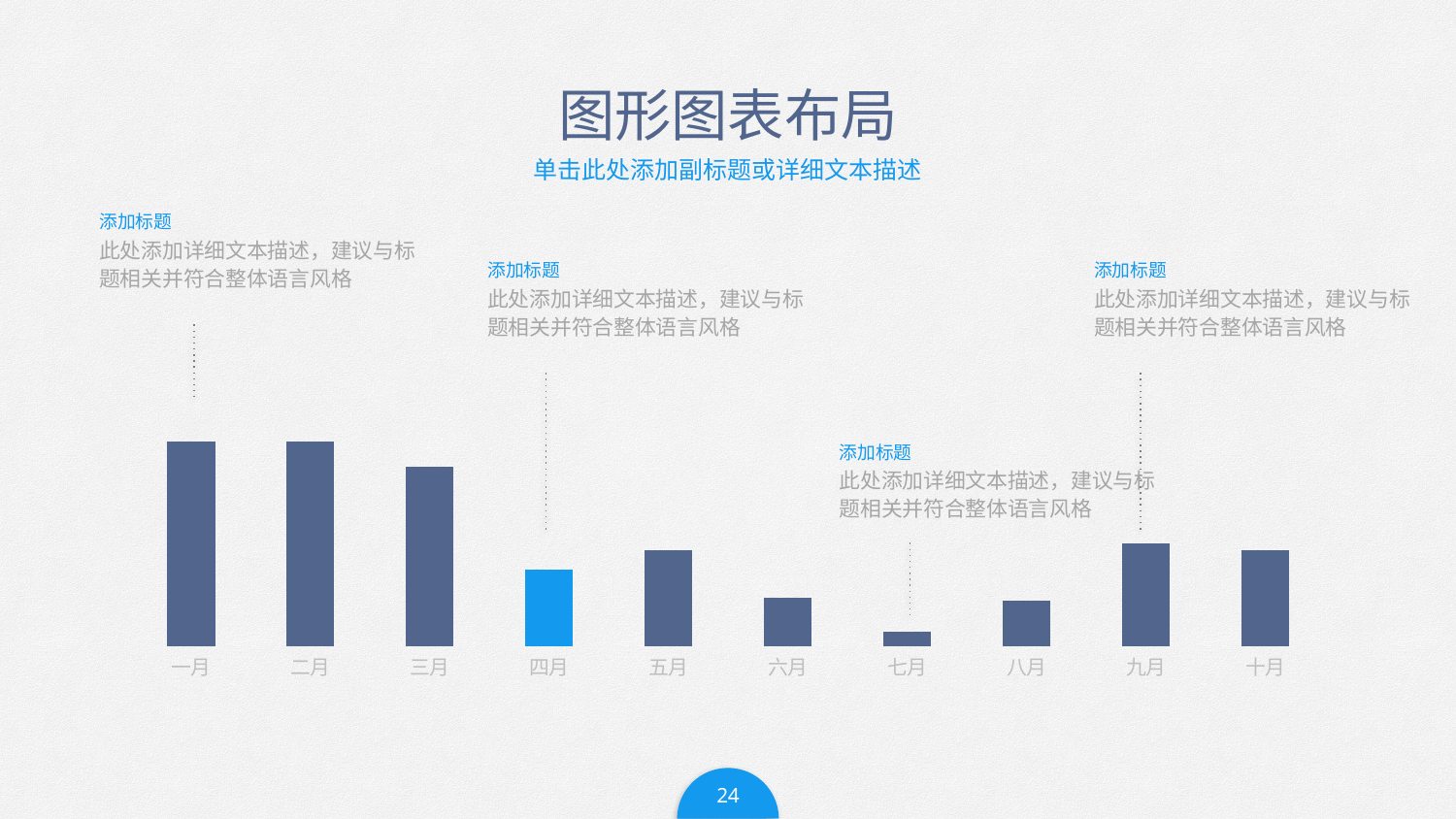
Do the values rise or fall from 七月 to 九月? rise Which is larger, the value for 八月 or the value for 九月? 九月 What is the main title of the slide containing the chart? 图形图表布局 Do the values rise or fall from 五月 to 七月? fall Which is larger, the value for 一月 or the value for 四月? 一月 How many categories (months) are plotted on the x axis of the chart? 10 Which is larger, the value for 三月 or the value for 十月? 三月 What kind of chart is shown on the slide? bar chart Which month has the lowest bar in the chart? 七月 Which month's bar is highlighted in a different (bright blue) colour from the others? 四月